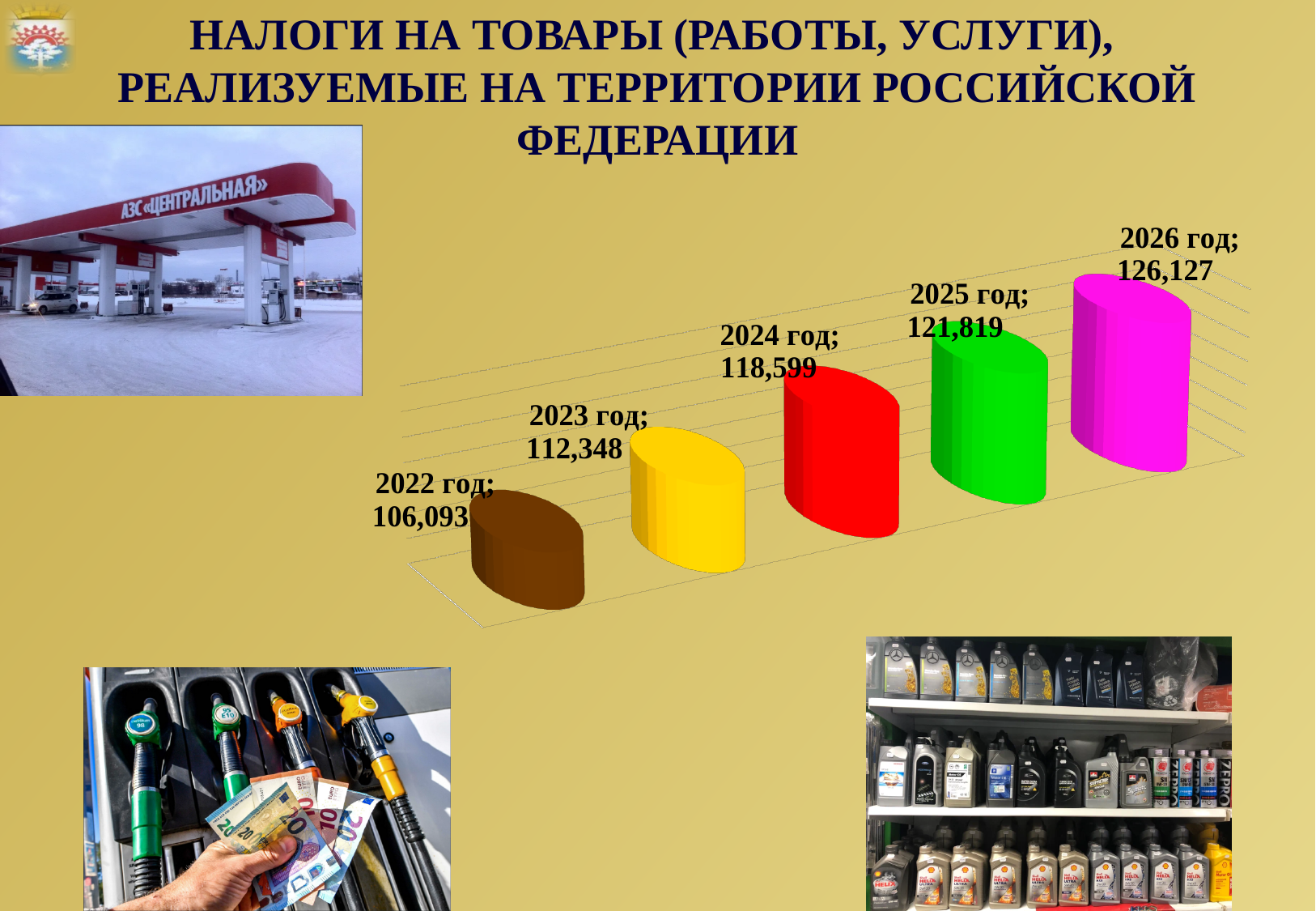
What is the difference between the values for 2026 год and 2022 год? 20,034 Which is larger, the value for 2025 год or the value for 2024 год? 2025 год What is the value for 2024 год? 118,599 Which year has the highest value? 2026 год Do the values rise or fall from 2022 год to 2026 год? rise What is the value for 2022 год? 106,093 How many years are shown in the chart? 5 What kind of chart is shown on the slide? bar chart What is the difference between the values for 2023 год and 2022 год? 6,255 Which year has the lowest value? 2022 год What colour is the bar for 2024 год? red What is the value for 2026 год? 126,127